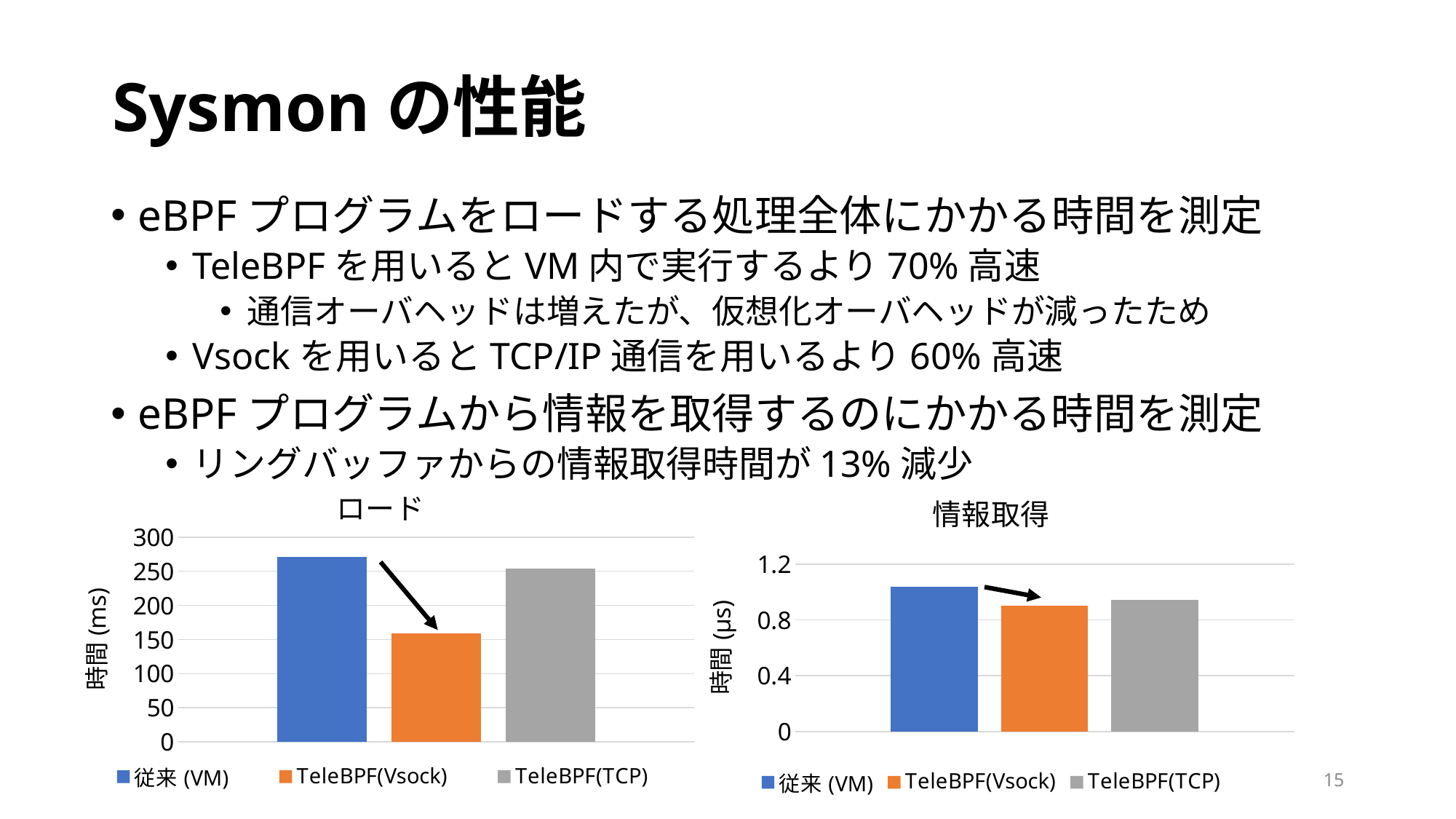
In the 情報取得 chart, what is the label of the vertical axis? 時間 (µs) In the ロード chart, which is larger, the value for TeleBPF(TCP) or the value for TeleBPF(Vsock)? TeleBPF(TCP) In the ロード chart, how many series does the legend list? 3 In the ロード chart, is the value for 従来 (VM) greater or less than 250? greater In the ロード chart, what kind of chart is shown? bar chart In the 情報取得 chart, is the value for TeleBPF(Vsock) greater or less than 1.2? less In the 情報取得 chart, which series has the highest value? 従来 (VM) In the ロード chart, which series has the lowest value? TeleBPF(Vsock) In the ロード chart, which series has the highest value? 従来 (VM) In the 情報取得 chart, is the value for 従来 (VM) greater or less than 0.8? greater In the ロード chart, what is the label of the vertical axis? 時間 (ms)